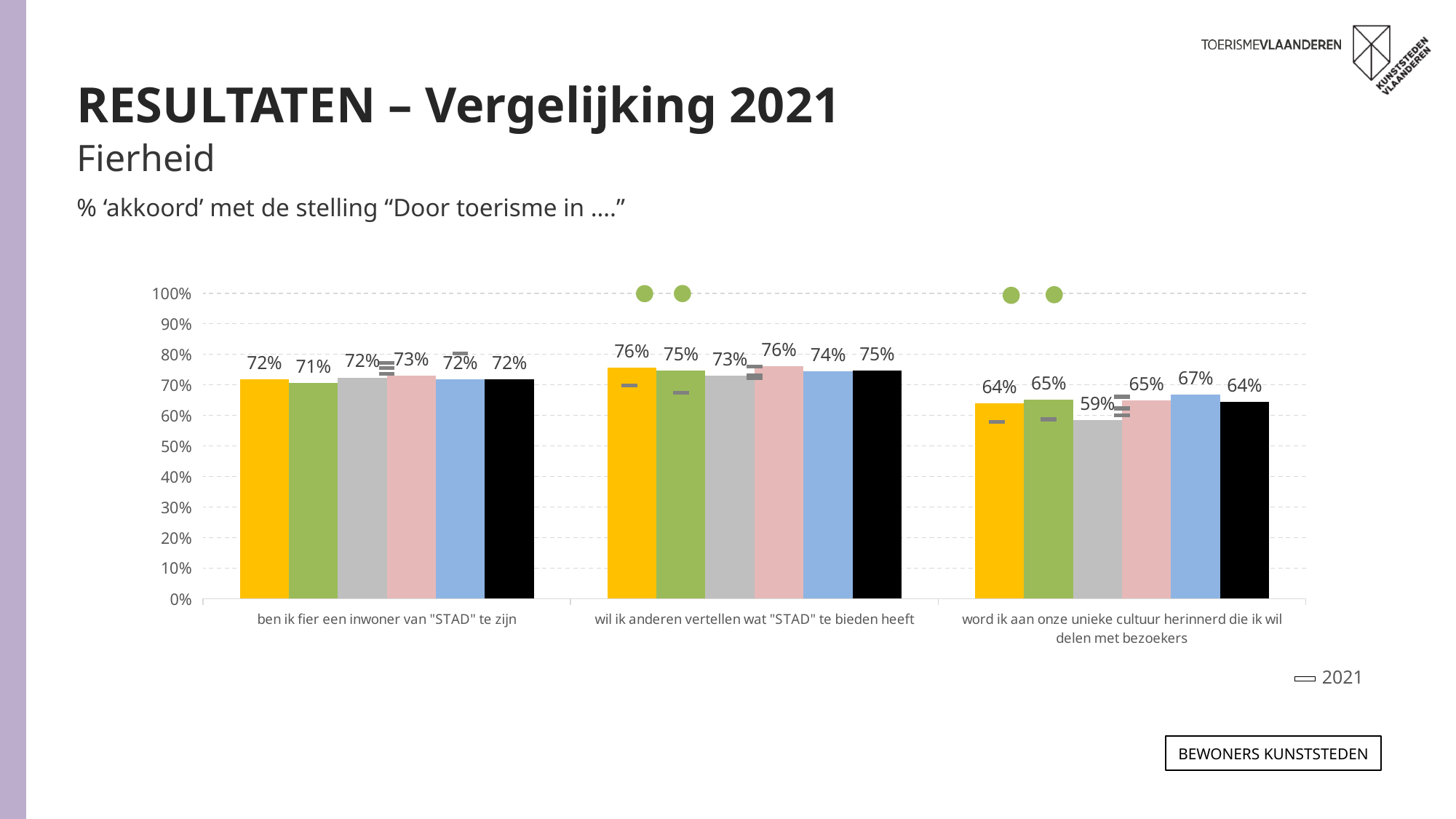
Which bar has the lowest value for "wil ik anderen vertellen wat "STAD" te bieden heeft"? the grey bar (73%) How many statement categories are shown along the x axis of the chart? 3 How many entries does the chart legend list? 1 What year does the legend marker in the chart refer to? 2021 What is the difference between the blue bar (67%) and the grey bar (59%) for "word ik aan onze unieke cultuur herinnerd die ik wil delen met bezoekers"? 8 percentage points Which bar has the highest value for "word ik aan onze unieke cultuur herinnerd die ik wil delen met bezoekers"? the blue bar (67%) What kind of chart is shown on the slide? bar chart Is the value of the grey bar for "word ik aan onze unieke cultuur herinnerd die ik wil delen met bezoekers" greater or less than 60%? less What is the value of the grey bar for "word ik aan onze unieke cultuur herinnerd die ik wil delen met bezoekers"? 59% For "ben ik fier een inwoner van "STAD" te zijn", which is larger: the pink bar or the green bar? the pink bar (73%) What is the value of the yellow bar for "ben ik fier een inwoner van "STAD" te zijn"? 72% What is the value of the blue bar for "wil ik anderen vertellen wat "STAD" te bieden heeft"? 74%